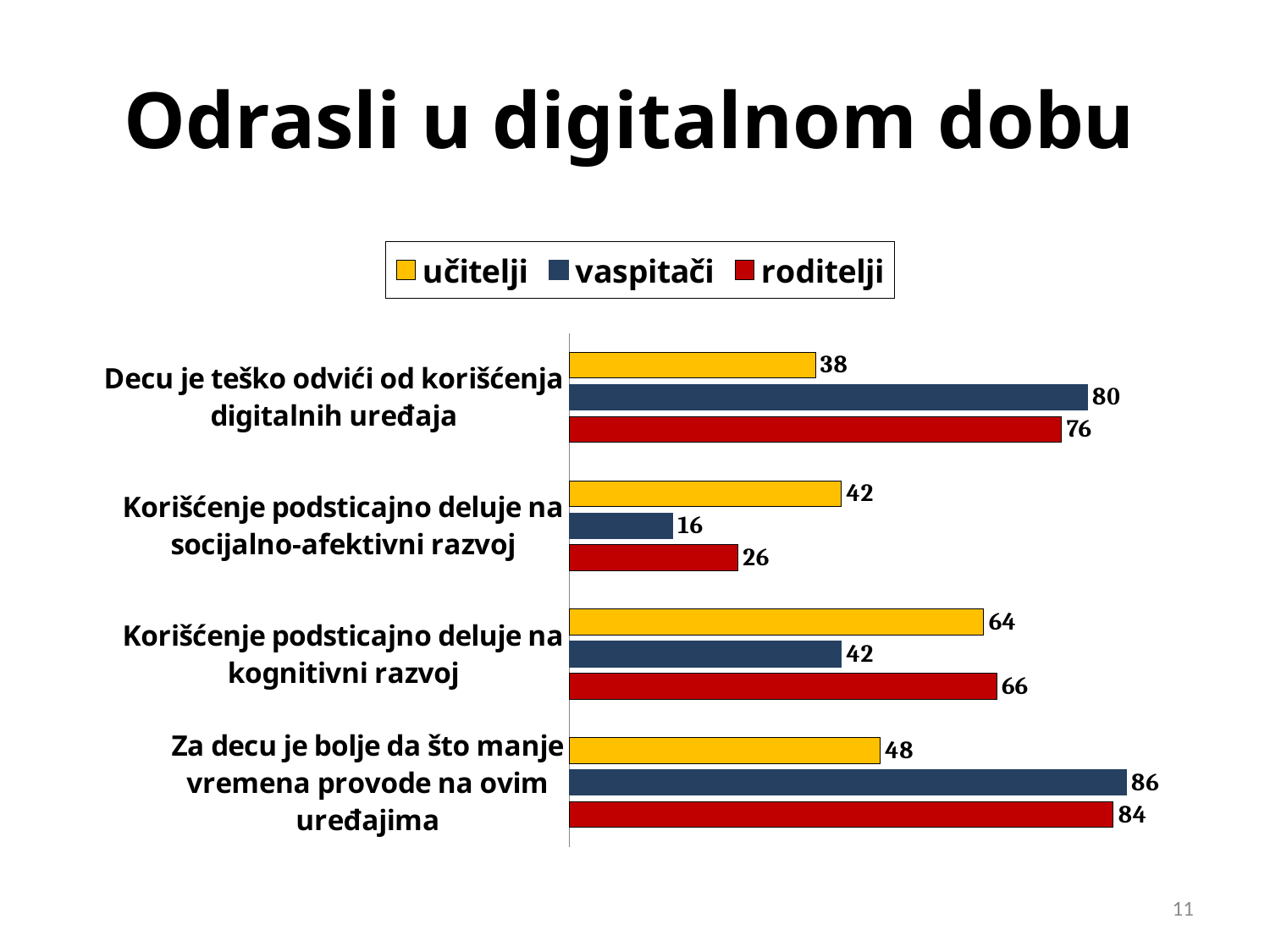
What is the title of the slide? Odrasli u digitalnom dobu How many series does the legend list? 3 What kind of chart is shown on the slide? bar chart What value is shown for roditelji on "Korišćenje podsticajno deluje na kognitivni razvoj"? 66 Which is larger for "Korišćenje podsticajno deluje na kognitivni razvoj": the učitelji value or the vaspitači value? učitelji What value is shown for učitelji on "Korišćenje podsticajno deluje na socijalno-afektivni razvoj"? 42 What value is shown for vaspitači on "Decu je teško odvići od korišćenja digitalnih uređaja"? 80 What is the difference between the roditelji and učitelji values for "Decu je teško odvići od korišćenja digitalnih uređaja"? 38 Which series has the lowest value for "Korišćenje podsticajno deluje na socijalno-afektivni razvoj"? vaspitači Which series has the highest value for "Za decu je bolje da što manje vremena provode na ovim uređajima"? vaspitači How many categories are shown on the chart? 4 Which colour represents roditelji in the legend? red